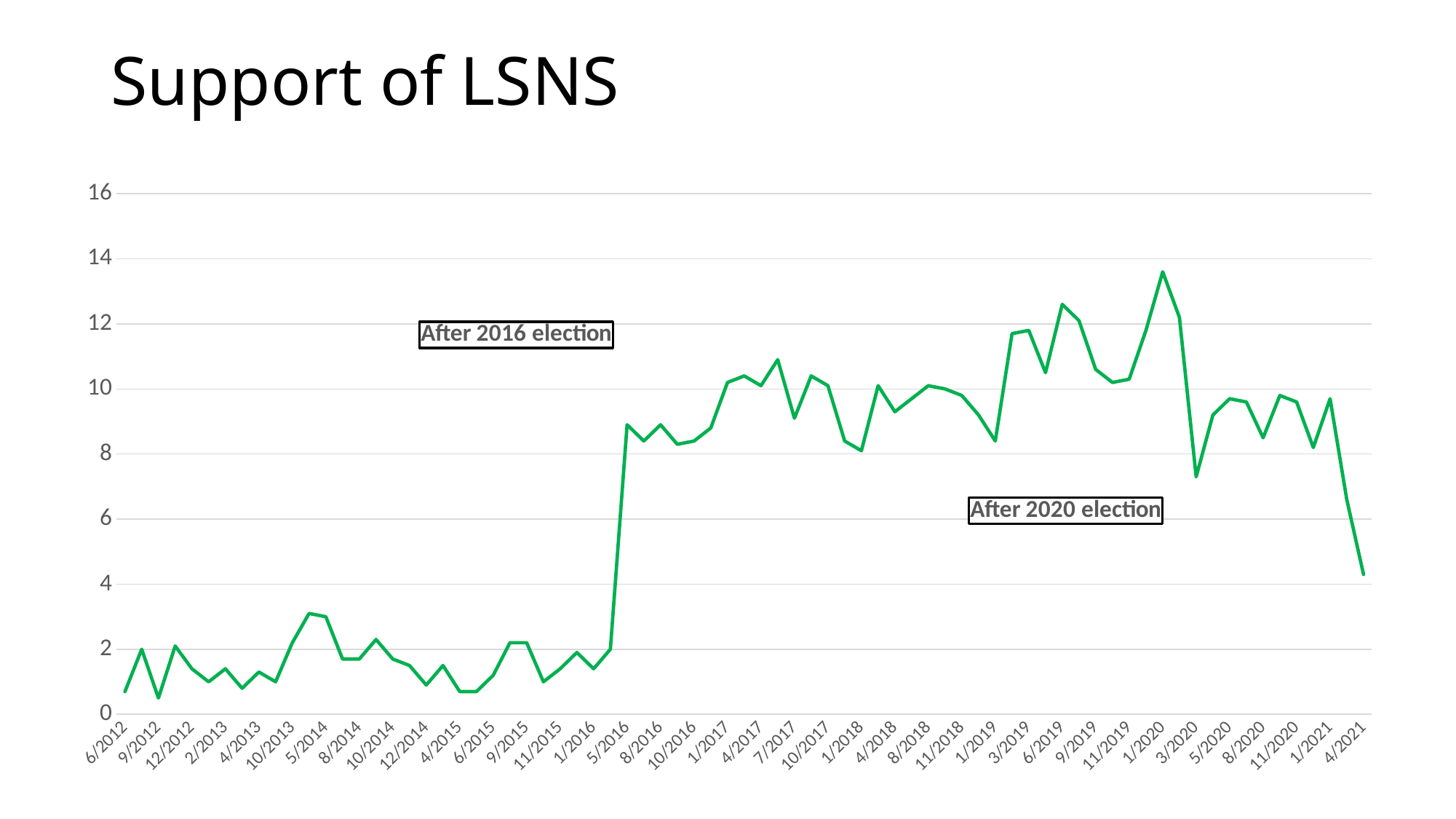
Is the value for 5/2014 greater or less than 4? less Which has the larger value, 1/2020 or 4/2021? 1/2020 At which x-axis date does the line reach its highest value? 1/2020 Is the value for 3/2020 greater or less than 8? less Is the value for 4/2021 greater or less than 6? less Which has the larger value, 1/2016 or 5/2016? 5/2016 What colour is the line in the chart? green What kind of chart is shown on the slide? line chart Does the line rise or fall between 1/2021 and 4/2021? fall What is the title of the chart? Support of LSNS